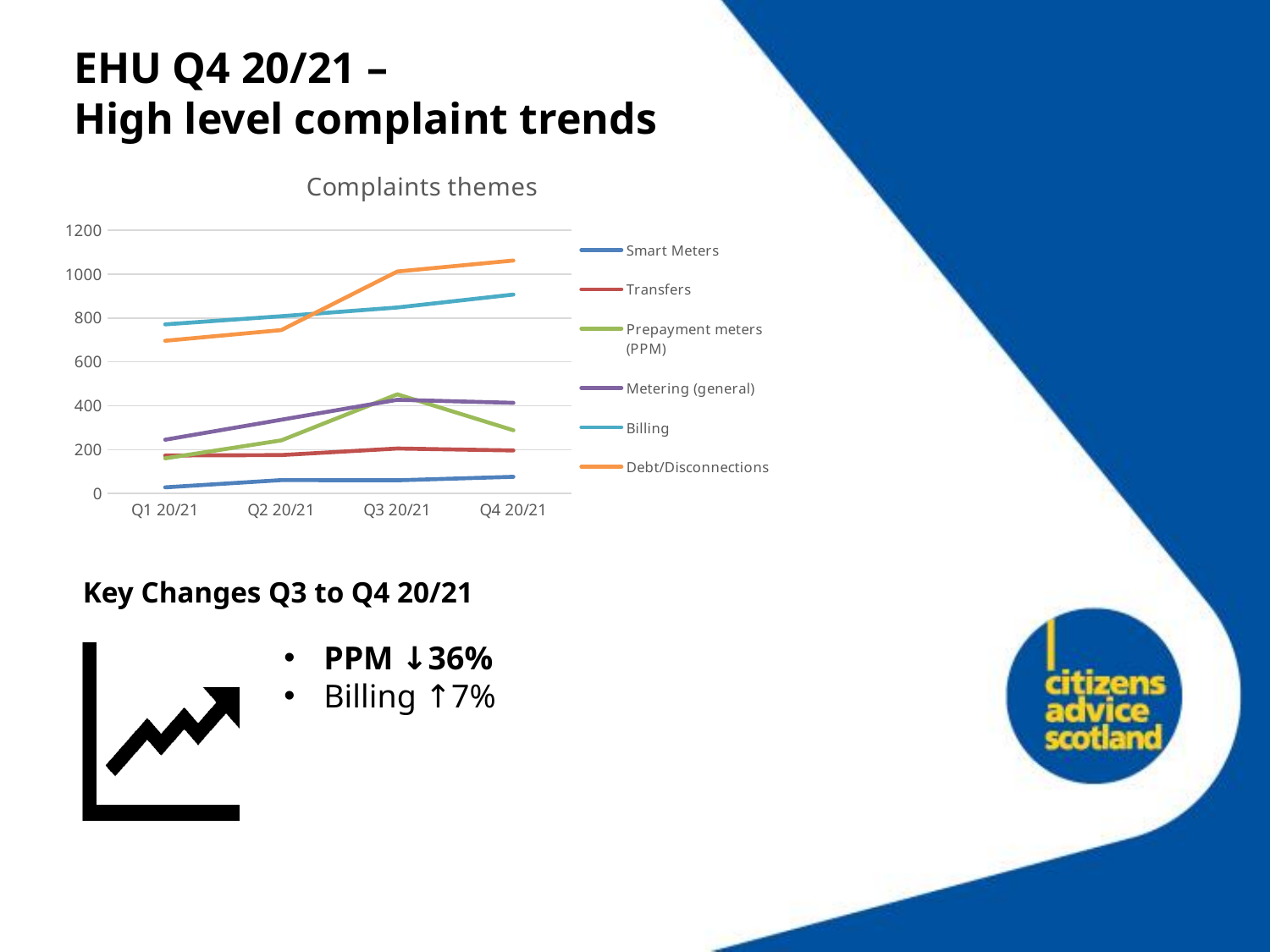
What is the title of the chart? Complaints themes How many quarters are plotted along the x axis? 4 At Q4 20/21, which is larger: Metering (general) or Prepayment meters (PPM)? Metering (general) Is the value for Smart Meters at Q1 20/21 greater or less than 200? less Does the Debt/Disconnections line rise or fall from Q1 20/21 to Q4 20/21? rise How many series does the legend list? 6 What kind of chart is shown on the slide? line chart Is the value for Debt/Disconnections at Q4 20/21 greater or less than 1000? greater Which series has the lowest value at Q4 20/21? Smart Meters Is the value for Prepayment meters (PPM) at Q3 20/21 greater or less than 400? greater At Q1 20/21, which is larger: Billing or Debt/Disconnections? Billing Which series has the highest value at Q4 20/21? Debt/Disconnections